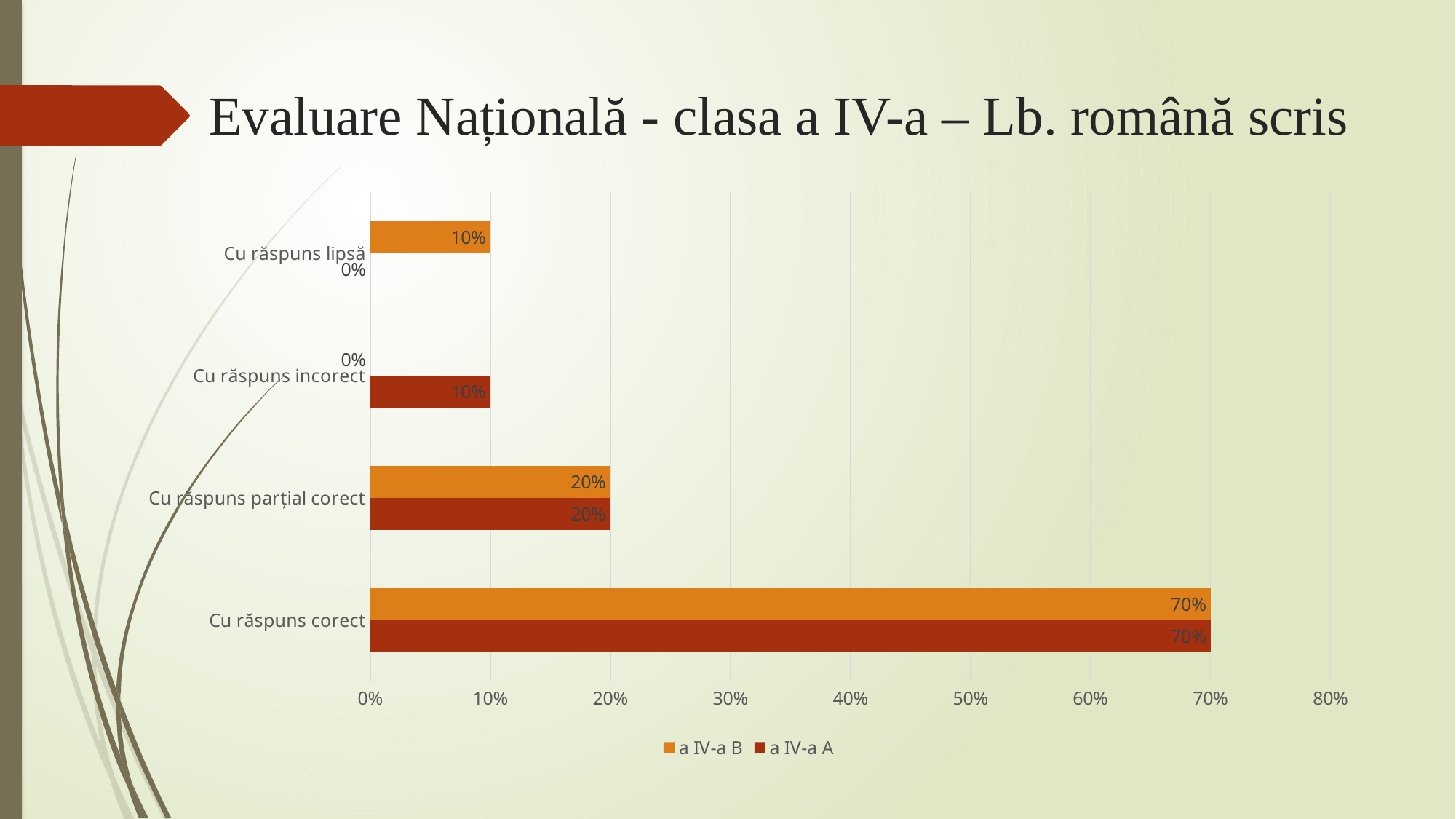
What is the title of the chart on the slide? Evaluare Națională - clasa a IV-a – Lb. română scris What is the value for a IV-a B in the category "Cu răspuns corect"? 70% Which is larger: the a IV-a B value for "Cu răspuns lipsă" or the a IV-a A value for "Cu răspuns lipsă"? a IV-a B What kind of chart is shown on the slide? bar chart What is the difference between the a IV-a B values for "Cu răspuns corect" and "Cu răspuns parțial corect"? 50% Which category has the highest value for a IV-a A? Cu răspuns corect How many categories are shown on the chart? 4 What is the value for a IV-a A in the category "Cu răspuns parțial corect"? 20% Which category has the lowest value for a IV-a B? Cu răspuns incorect What is the value for a IV-a A in the category "Cu răspuns incorect"? 10% What is the value for a IV-a B in the category "Cu răspuns lipsă"? 10% How many series does the legend list? 2